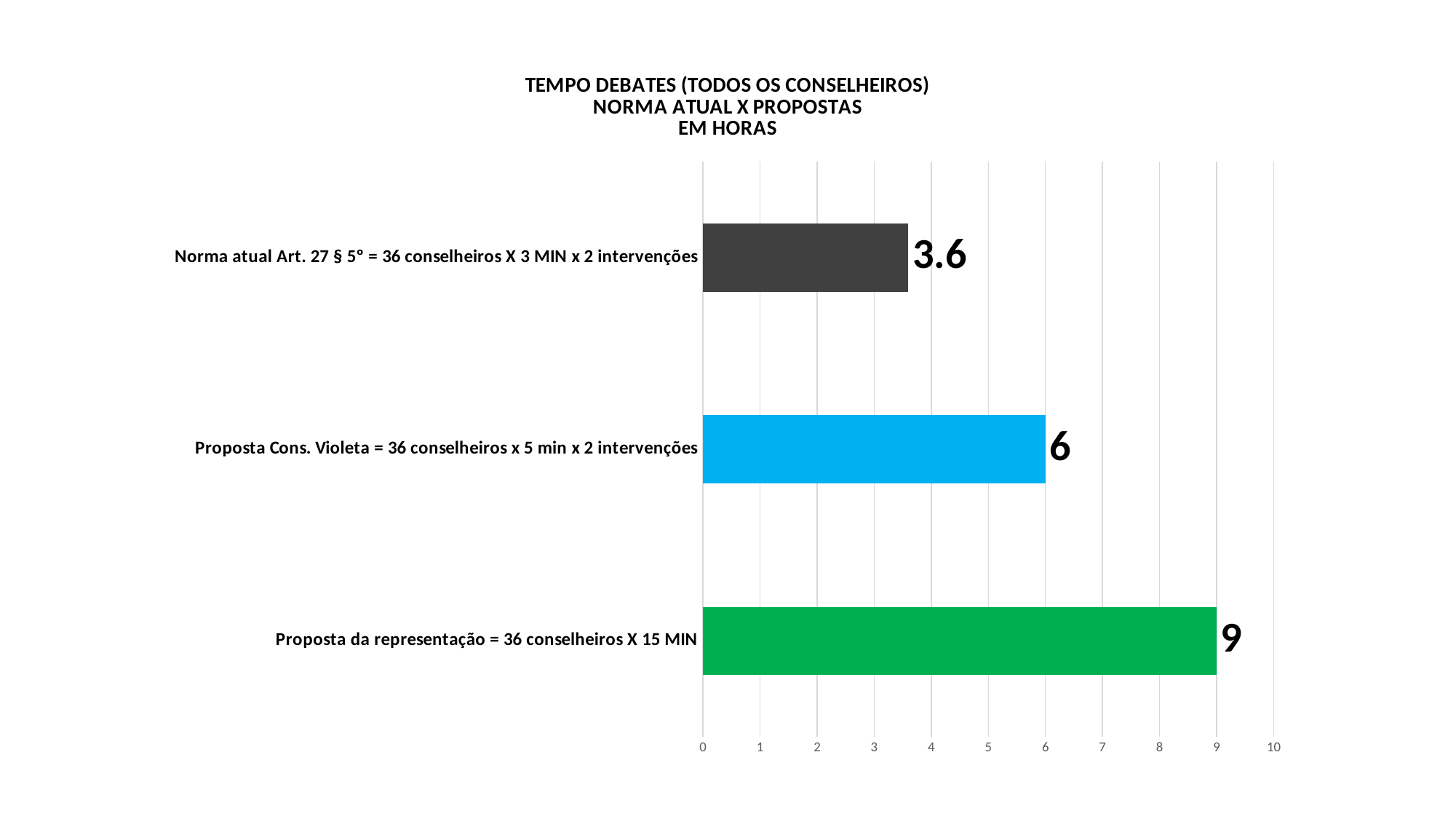
What is the value for "Proposta da representação = 36 conselheiros X 15 MIN"? 9 Which is larger: the value for "Proposta Cons. Violeta" or the value for "Norma atual Art. 27 § 5°"? Proposta Cons. Violeta What kind of chart is shown on the slide? bar chart What is the difference between the value for "Proposta da representação" and the value for "Norma atual Art. 27 § 5°"? 5.4 Which category has the highest value? Proposta da representação = 36 conselheiros X 15 MIN Is the value for "Norma atual Art. 27 § 5°" greater or less than 4? less Which category has the lowest value? Norma atual Art. 27 § 5° = 36 conselheiros X 3 MIN x 2 intervenções What is the value for "Norma atual Art. 27 § 5° = 36 conselheiros X 3 MIN x 2 intervenções"? 3.6 How many categories are shown in the chart? 3 What is the difference between the value for "Proposta da representação" and the value for "Proposta Cons. Violeta"? 3 What is the value for "Proposta Cons. Violeta = 36 conselheiros x 5 min x 2 intervenções"? 6 What colour is the bar for "Proposta da representação = 36 conselheiros X 15 MIN"? green